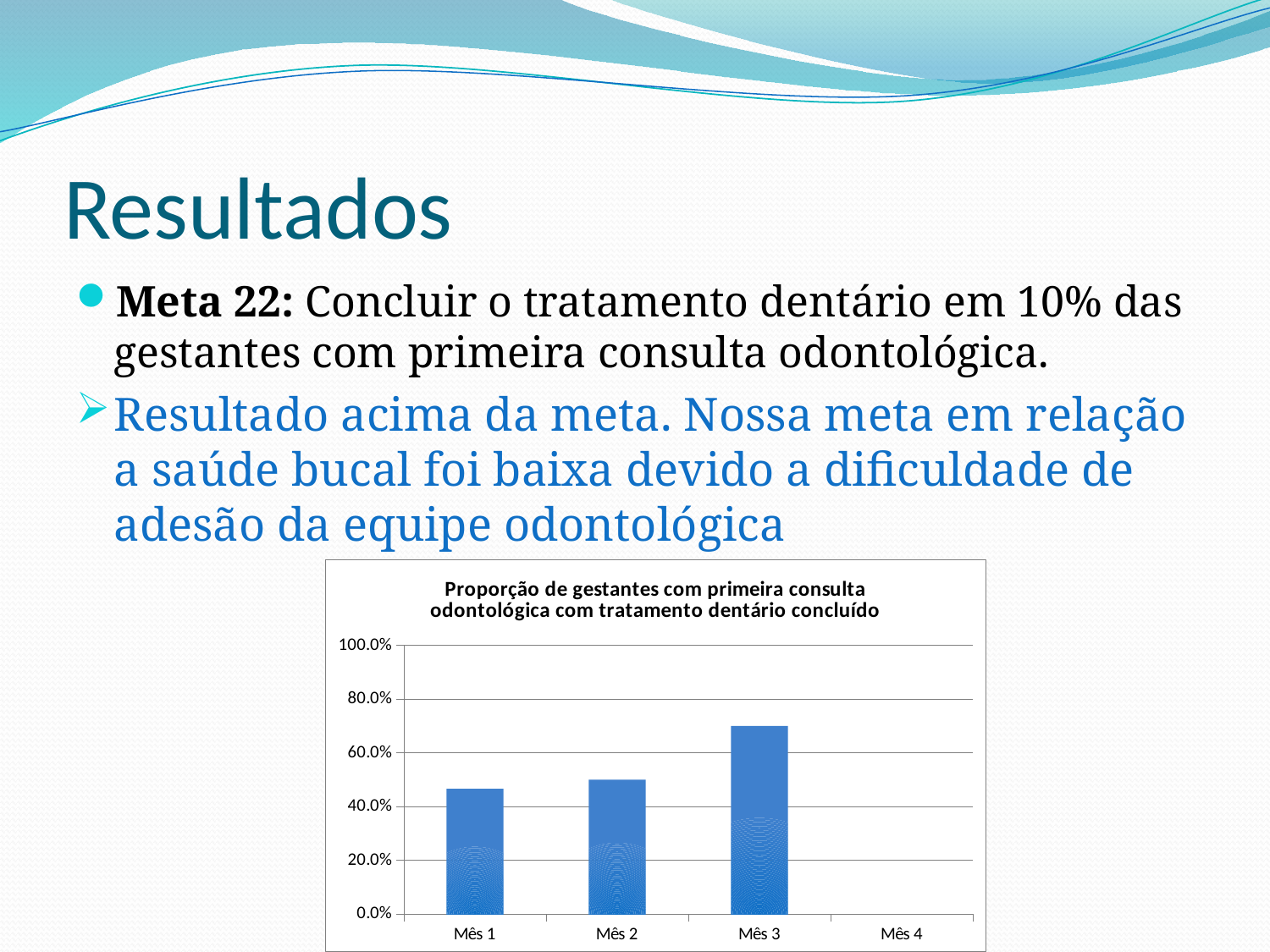
How many categories are shown on the x axis of the chart? 4 Which is larger, the value for Mês 1 or the value for Mês 3? Mês 3 Is the value for Mês 3 greater or less than 60.0%? greater Is the value for Mês 3 greater or less than 80.0%? less Is the value for Mês 1 greater or less than 60.0%? less Which month has the highest value in the chart? Mês 3 Which month on the x axis has no visible bar? Mês 4 What kind of chart is shown on the slide? Bar chart What is the title of the chart? Proporção de gestantes com primeira consulta odontológica com tratamento dentário concluído Do the values rise or fall from Mês 1 to Mês 3? rise